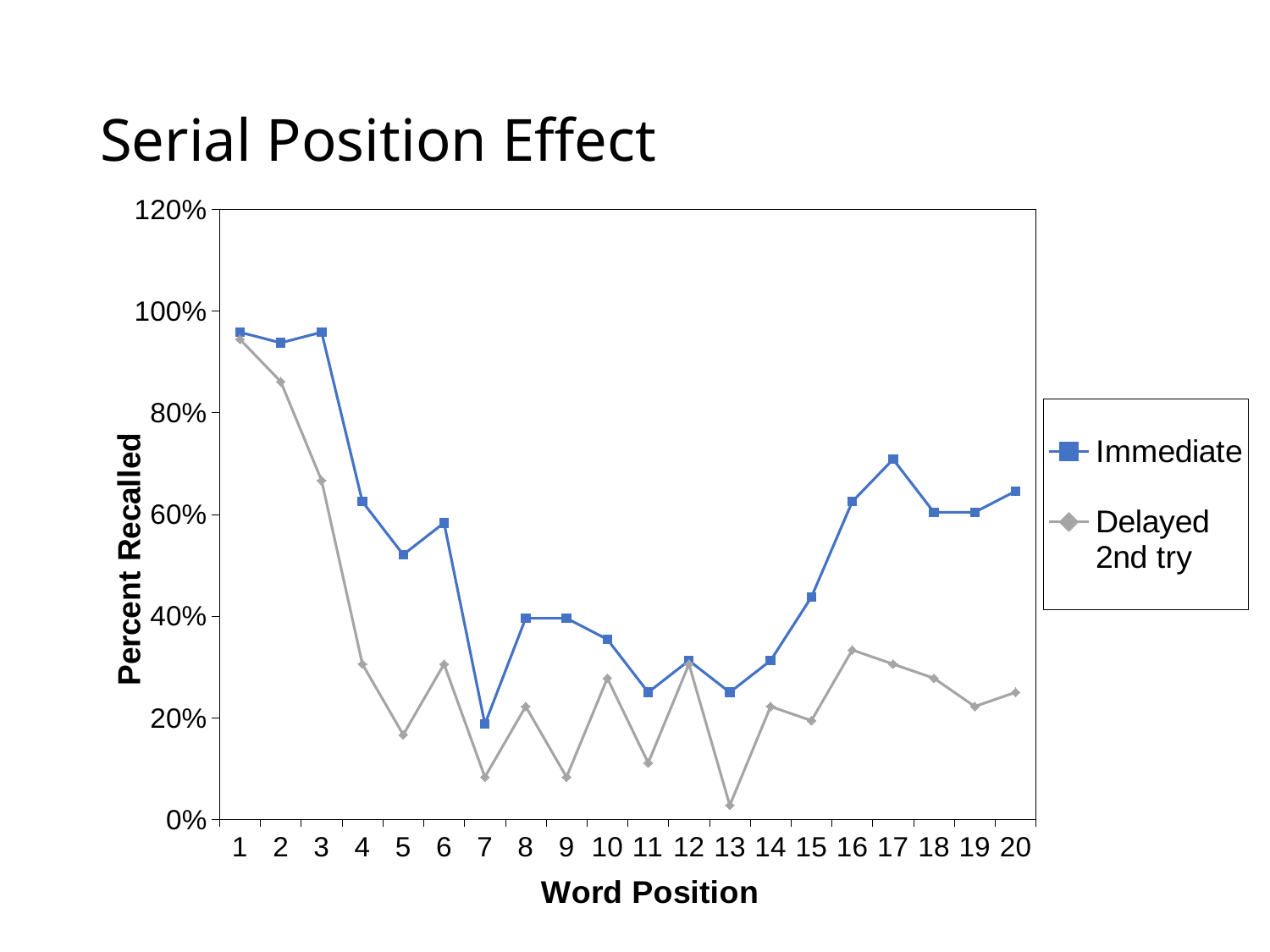
At which word position does the Immediate series reach its lowest value? 7 How many series does the legend list? 2 Is the Delayed 2nd try value at word position 13 greater or less than 20%? less Which series has the lowest value at word position 13? Delayed 2nd try What kind of chart is shown on the slide? line chart What is the label of the y axis? Percent Recalled At which word position does the Delayed 2nd try series reach its lowest value? 13 Is the Immediate value at word position 17 greater or less than 60%? greater How many word positions are plotted along the x axis? 20 Does the Immediate series rise or fall from word position 1 to word position 7? fall Is the Immediate value at word position 12 greater or less than 40%? less At which word position does the Delayed 2nd try series reach its highest value? 1